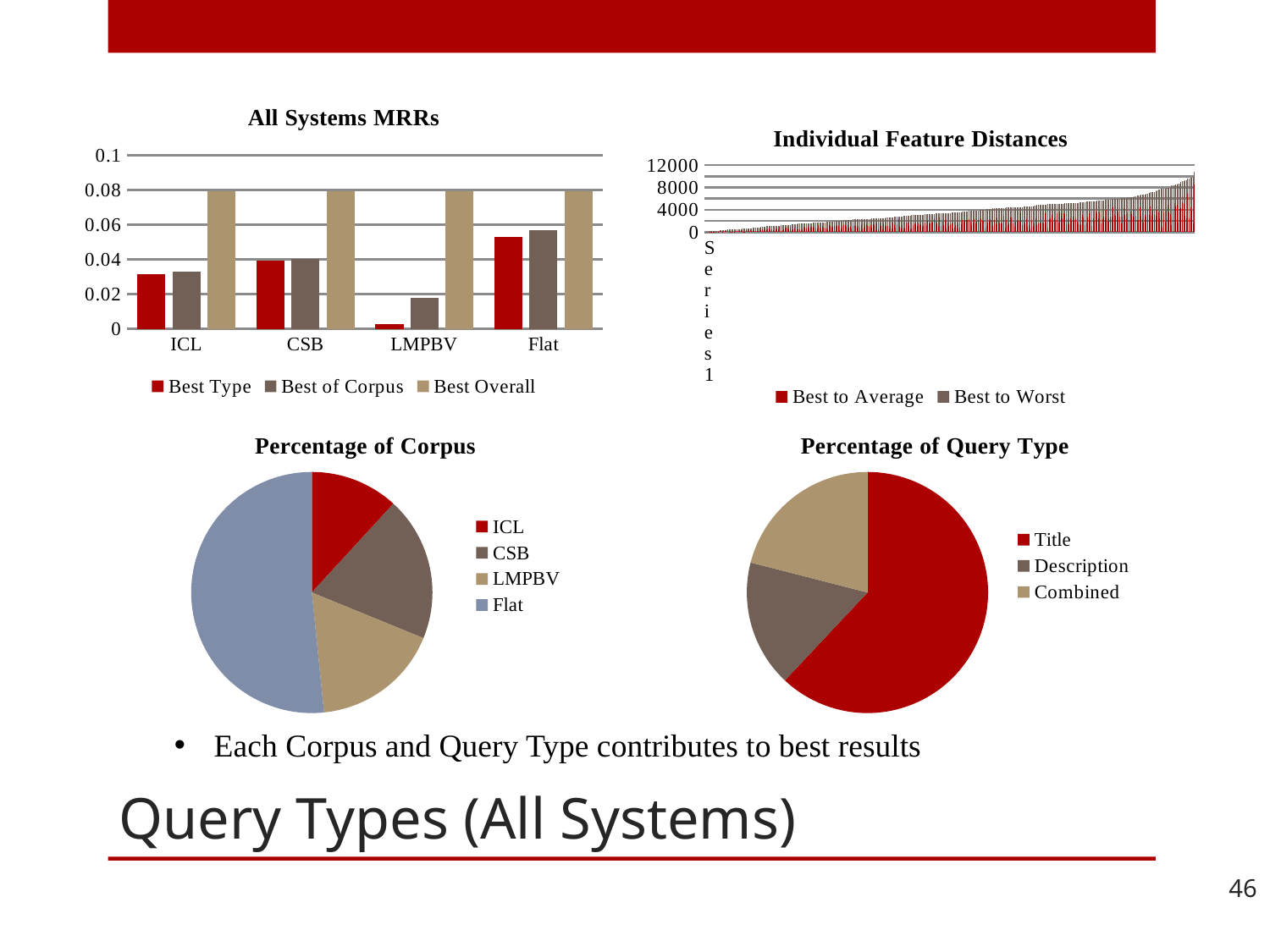
In the Percentage of Query Type chart, which category has the largest slice? Title In the Individual Feature Distances chart, do the values rise or fall along the x axis? rise How many slices does the Percentage of Corpus chart have? 4 In the All Systems MRRs chart, which is larger, the Best Type value for ICL or for CSB? CSB In the Percentage of Corpus chart, which category has the largest slice? Flat In the All Systems MRRs chart, is the Best of Corpus value for Flat greater or less than 0.04? greater In the All Systems MRRs chart, which category has the lowest Best Type value? LMPBV In the All Systems MRRs chart, is the Best Type value for LMPBV greater or less than 0.02? less How many series does the legend of the Individual Feature Distances chart list? 2 How many series does the legend of the All Systems MRRs chart list? 3 In the All Systems MRRs chart, which category has the highest Best Type value? Flat